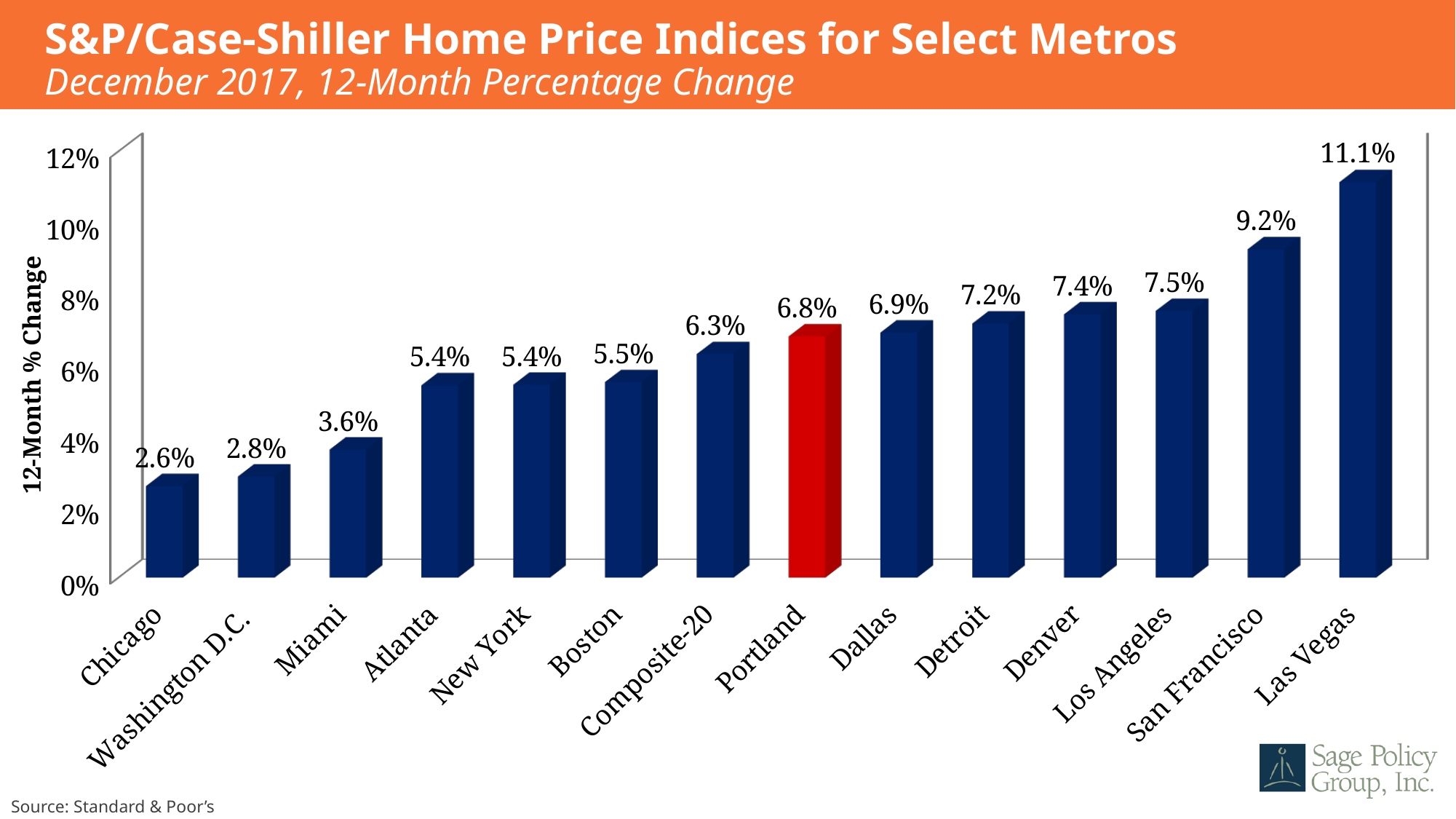
Which metro has the highest 12-month percentage change? Las Vegas What is the 12-month percentage change for the Composite-20? 6.3% What kind of chart is shown on the slide? Bar chart How many metros (bars) are shown on the chart? 14 What is the 12-month percentage change for Portland? 6.8% Which metro has the lowest 12-month percentage change? Chicago Which has a larger 12-month percentage change, Dallas or Boston? Dallas Is the value for Los Angeles greater or less than 6%? greater What is the 12-month percentage change for San Francisco? 9.2% What is the difference between the 12-month percentage change for Denver and Miami? 3.8% What is the difference between the 12-month percentage change for Las Vegas and Chicago? 8.5% Which bar is highlighted in red? Portland